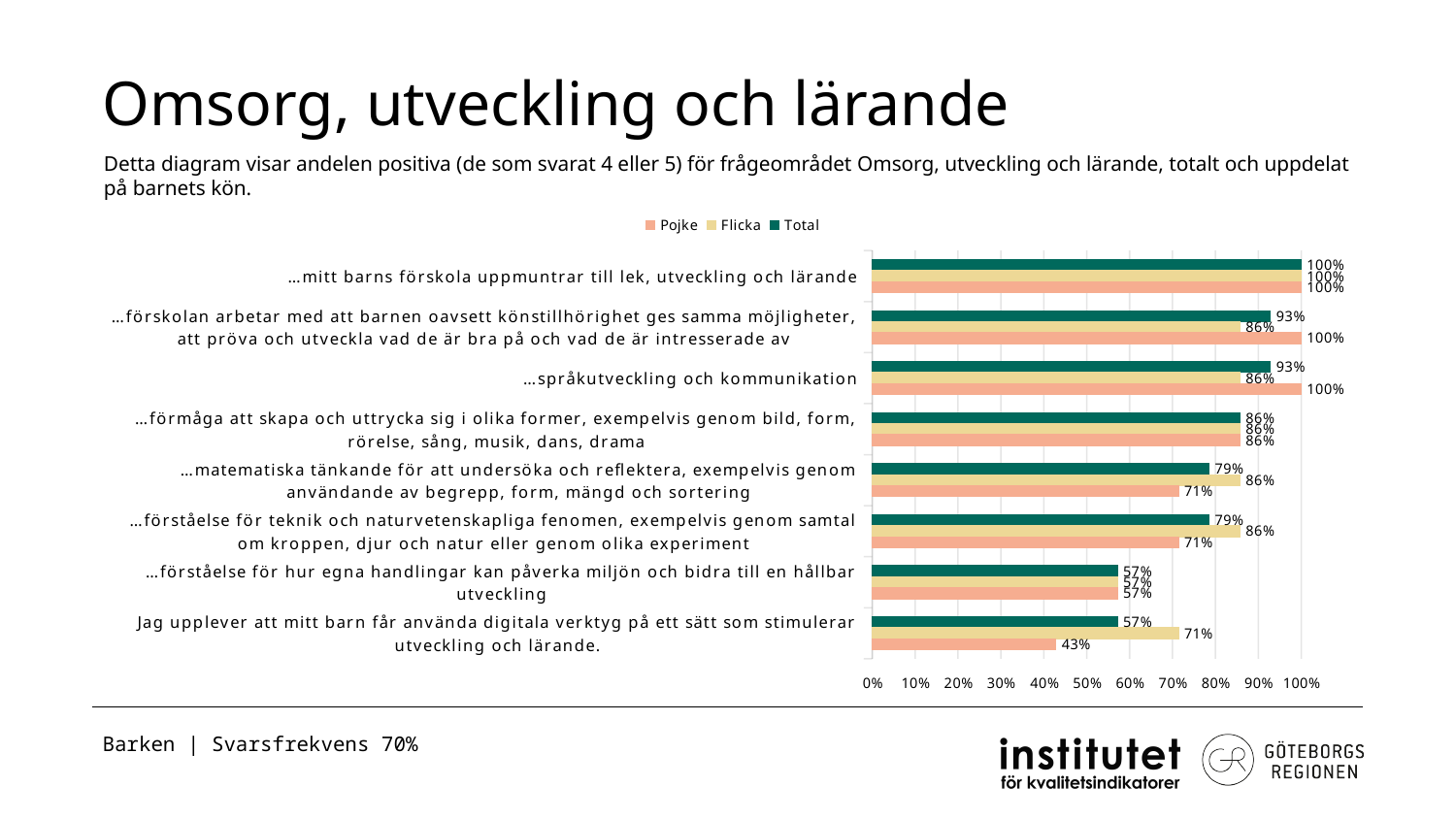
Which series is shown in dark green in the legend? Total How many series does the legend list? 3 What is the Total value for "…förståelse för hur egna handlingar kan påverka miljön och bidra till en hållbar utveckling"? 57% What is the Pojke value for "…språkutveckling och kommunikation"? 100% What is the difference between the Flicka and Pojke values for "Jag upplever att mitt barn får använda digitala verktyg på ett sätt som stimulerar utveckling och lärande."? 28% For "…förskolan arbetar med att barnen oavsett könstillhörighet ges samma möjligheter…", which is larger, the Pojke value or the Flicka value? Pojke What is the Flicka value for "Jag upplever att mitt barn får använda digitala verktyg på ett sätt som stimulerar utveckling och lärande."? 71% What is the Total value for "…matematiska tänkande för att undersöka och reflektera, exempelvis genom användande av begrepp, form, mängd och sortering"? 79% How many categories (statements) are plotted in the chart? 8 Which category has the highest Total value? …mitt barns förskola uppmuntrar till lek, utveckling och lärande Which category has the lowest Pojke value? Jag upplever att mitt barn får använda digitala verktyg på ett sätt som stimulerar utveckling och lärande. What type of chart is shown on the slide? bar chart